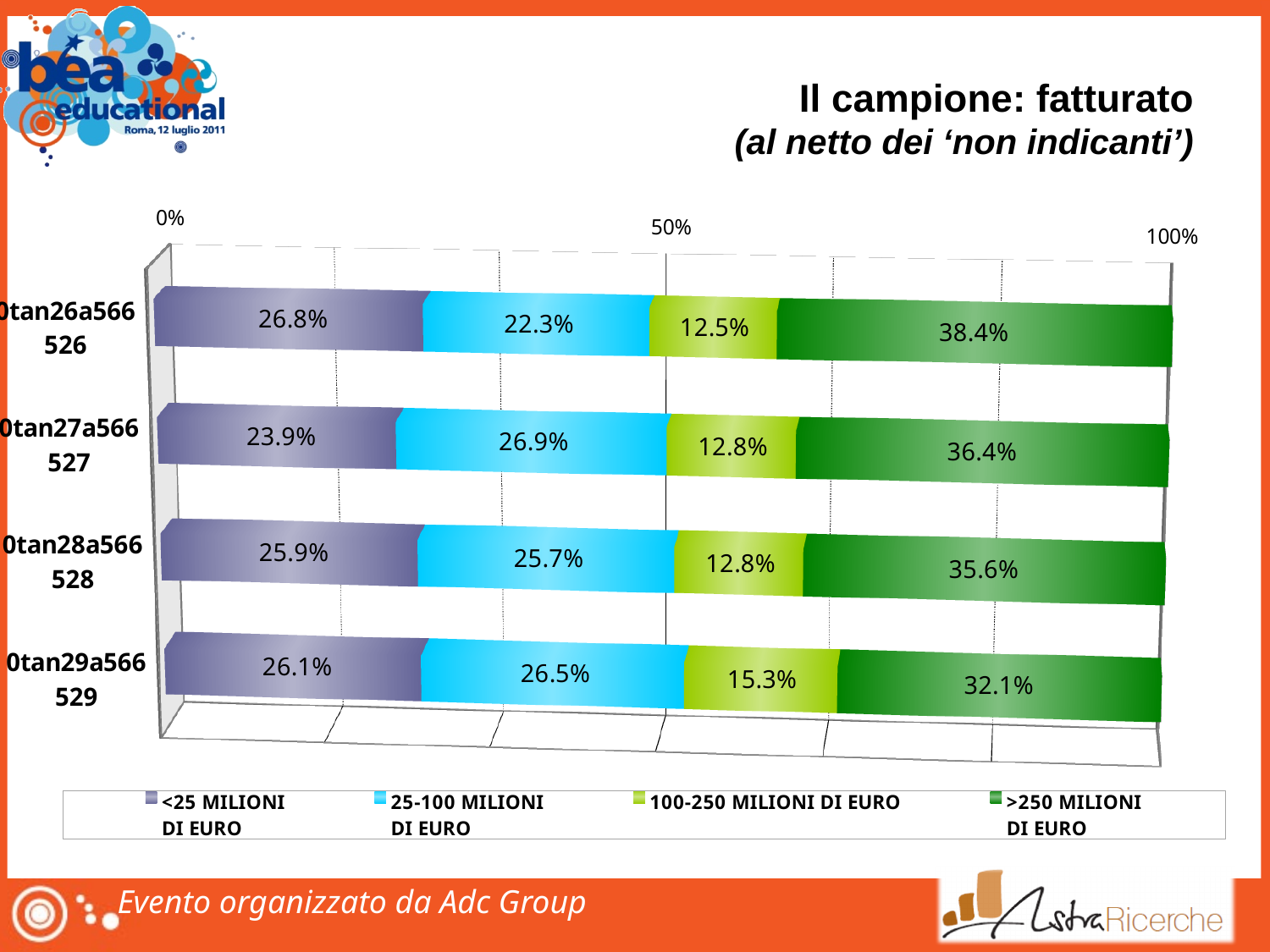
Which bar has the lowest value for the '>250 MILIONI DI EURO' segment? The bottom bar (529), 32.1% What kind of chart is shown on the slide? Stacked bar chart In the second bar from the top (labelled 527), which is larger: the '<25 MILIONI DI EURO' segment or the '25-100 MILIONI DI EURO' segment? 25-100 MILIONI DI EURO (26.9%) How many series does the legend list? 4 In the third bar from the top (labelled 528), what is the value for the '25-100 MILIONI DI EURO' segment? 25.7% How many bars (categories) are plotted in the chart? 4 In the top bar (labelled 526), what is the value for the '>250 MILIONI DI EURO' segment? 38.4% In the top bar (labelled 526), what is the difference between the '>250 MILIONI DI EURO' segment and the '<25 MILIONI DI EURO' segment? 11.6 percentage points Which bar has the highest value for the '>250 MILIONI DI EURO' segment? The top bar (526), 38.4% In the bottom bar (labelled 529), what is the value for the '100-250 MILIONI DI EURO' segment? 15.3% What colour is used for the '>250 MILIONI DI EURO' series? Dark green Which bar has the highest value for the '100-250 MILIONI DI EURO' segment? The bottom bar (529), 15.3%